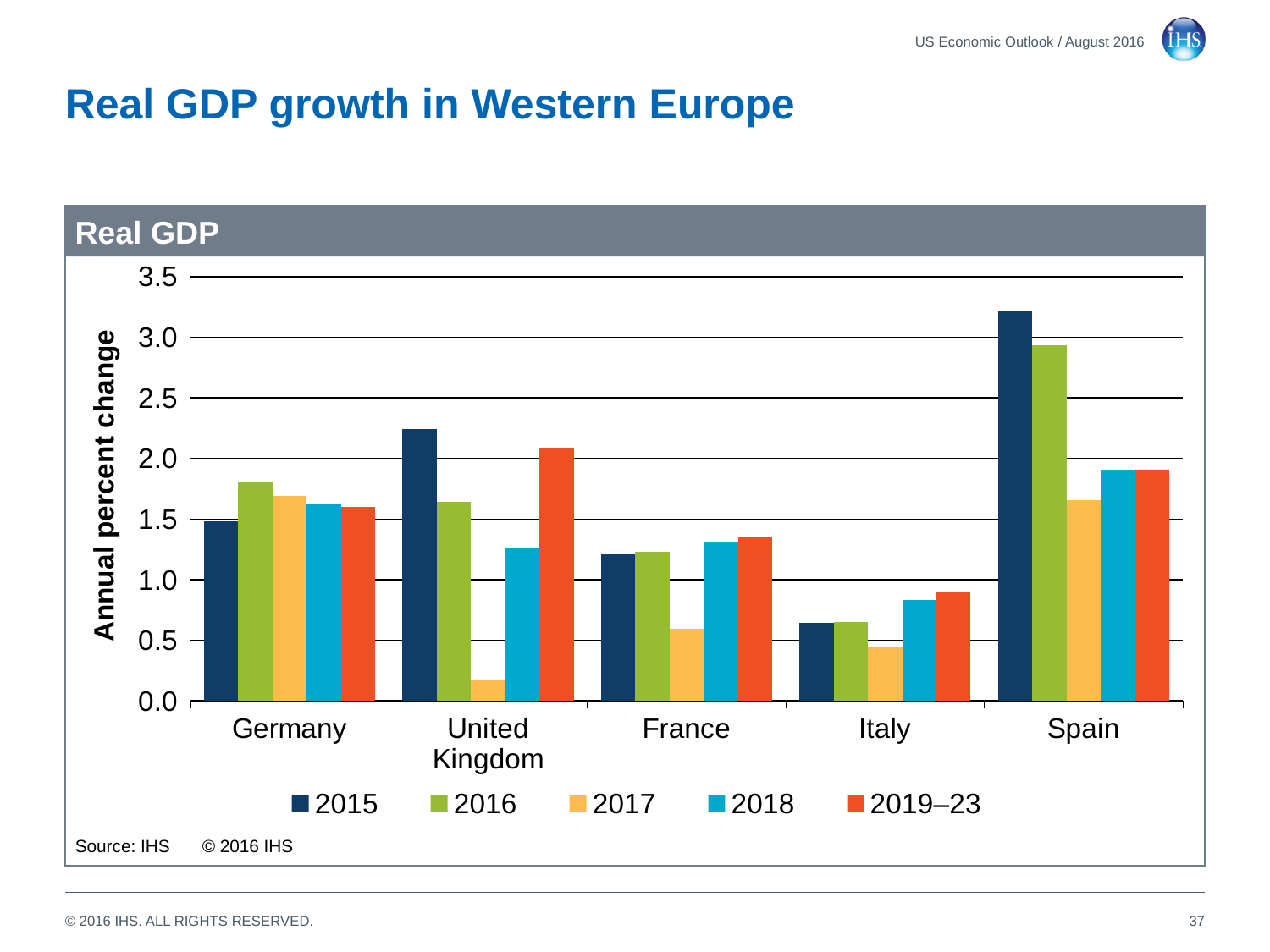
How many series does the legend list? 5 What is the title of the y axis? Annual percent change Which country has the highest value for 2015? Spain Is the value for the United Kingdom in 2017 greater or less than 0.5? less Is the value for Italy in 2019–23 greater or less than 1.0? less What kind of chart is shown on the slide? bar chart How many countries are shown on the x axis? 5 Which is larger for 2016: Germany or Italy? Germany Which country has the lowest value for 2017? United Kingdom For the United Kingdom, which is larger: the 2015 value or the 2016 value? 2015 What is the title shown in the chart's header bar? Real GDP Is the value for Spain in 2015 greater or less than 3.0? greater